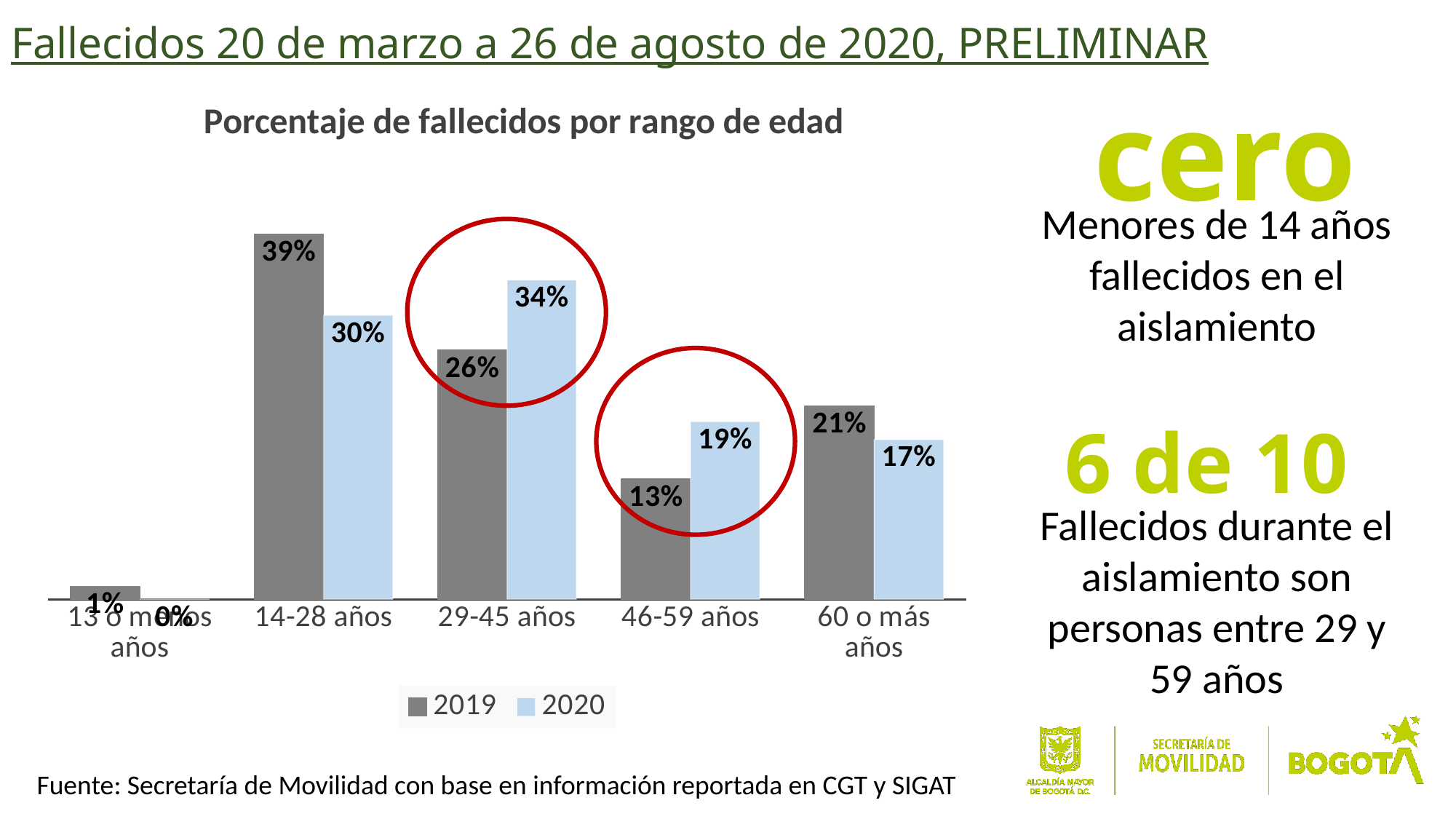
What is the 2020 value for the 60 o más años age range? 17% What kind of chart is shown on the slide? Bar chart How many age ranges are shown on the x axis? 5 What is the 2019 value for the 46-59 años age range? 13% Which age range has the lowest 2020 value? 13 o menos años What is the difference between the 2020 and 2019 values for the 46-59 años age range? 6% Which age range has the highest 2020 value? 29-45 años Which age range has the highest 2019 value? 14-28 años What is the 2020 value for the 29-45 años age range? 34% What is the 2019 value for the 14-28 años age range? 39% How many series does the legend list? 2 Which is larger for the 60 o más años age range, the 2019 value or the 2020 value? 2019